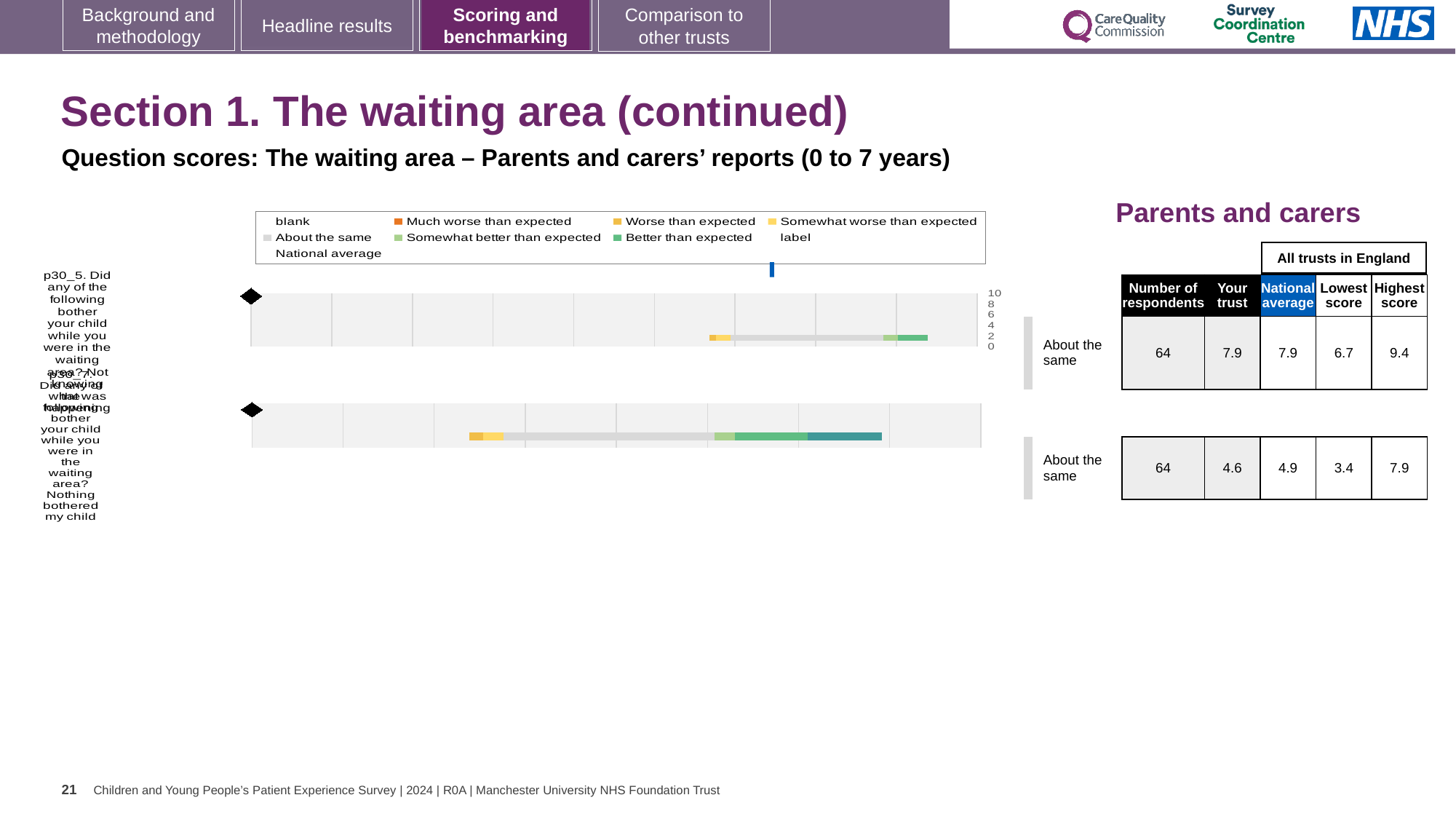
How many entries does the chart legend list? 9 How many respondents are listed for each question in the table? 64 Which question has the higher 'Your trust' score, p30_5 or p30_7? p30_5 In the table, what is the 'Your trust' score for the first question (p30_5)? 7.9 What kind of chart is shown on the left of the slide? bar chart How many question bars are plotted in the chart? 2 In the table, what is the national average for the second question (p30_7)? 4.9 In the table, what is the lowest score among all trusts in England for the second question (p30_7)? 3.4 What is the difference between the 'Your trust' scores for p30_5 (7.9) and p30_7 (4.6)? 3.3 In the table, what is the 'Your trust' score for the second question (p30_7)? 4.6 What benchmark category is shown next to both bars in the chart? About the same In the table, what is the highest score among all trusts in England for the first question (p30_5)? 9.4